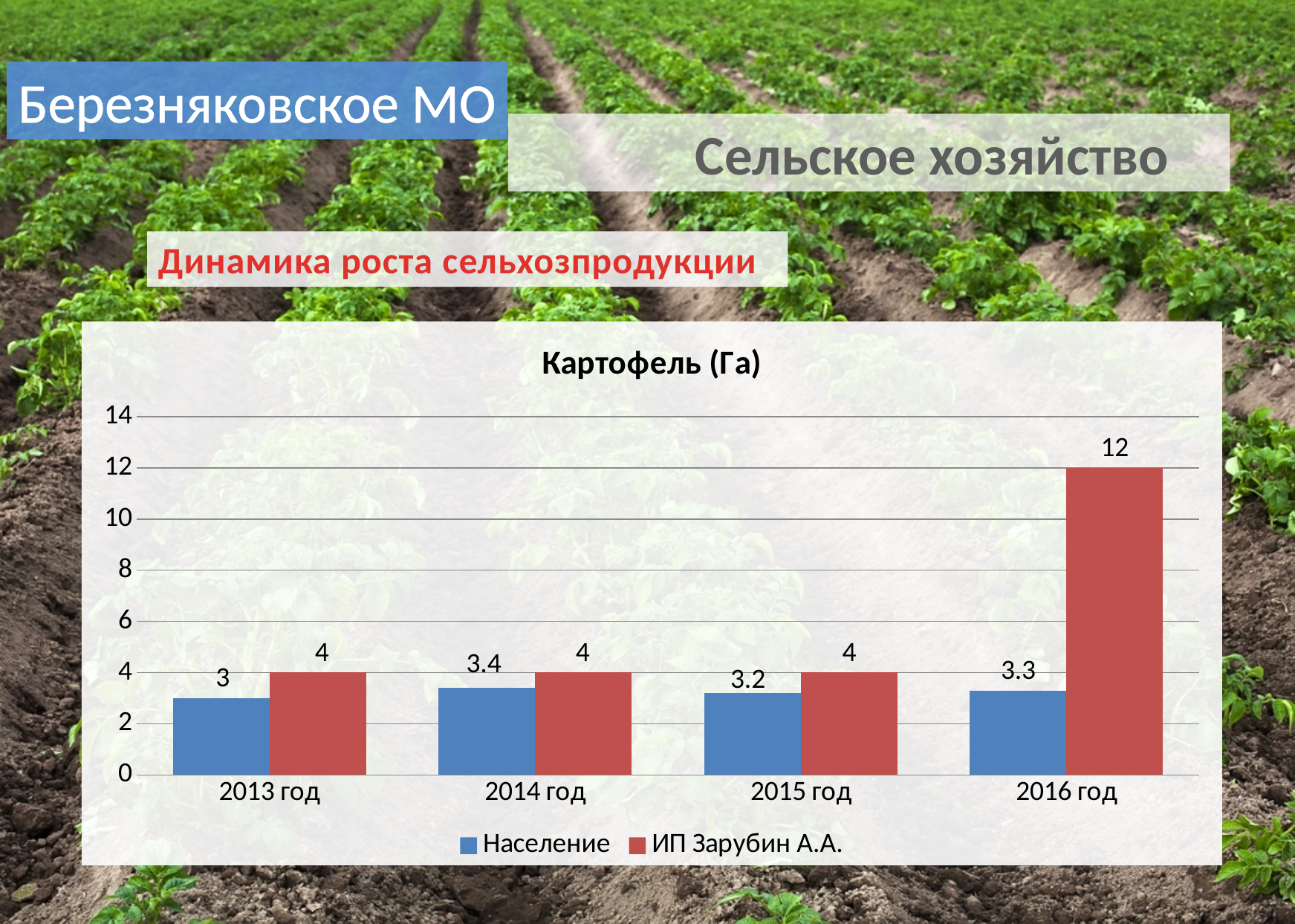
What is the value for Население in 2014 год? 3.4 What is the title of the chart? Картофель (Га) How many years are shown on the x axis? 4 Which is larger in 2015 год: Население or ИП Зарубин А.А.? ИП Зарубин А.А. What is the value for Население in 2013 год? 3 In which year is the value for Население the highest? 2014 год What is the value for ИП Зарубин А.А. in 2016 год? 12 What is the difference between ИП Зарубин А.А. and Население in 2016 год? 8.7 What kind of chart is shown? Bar chart How many series does the legend list? 2 What is the value for ИП Зарубин А.А. in 2015 год? 4 In which year is the value for Население the lowest? 2013 год